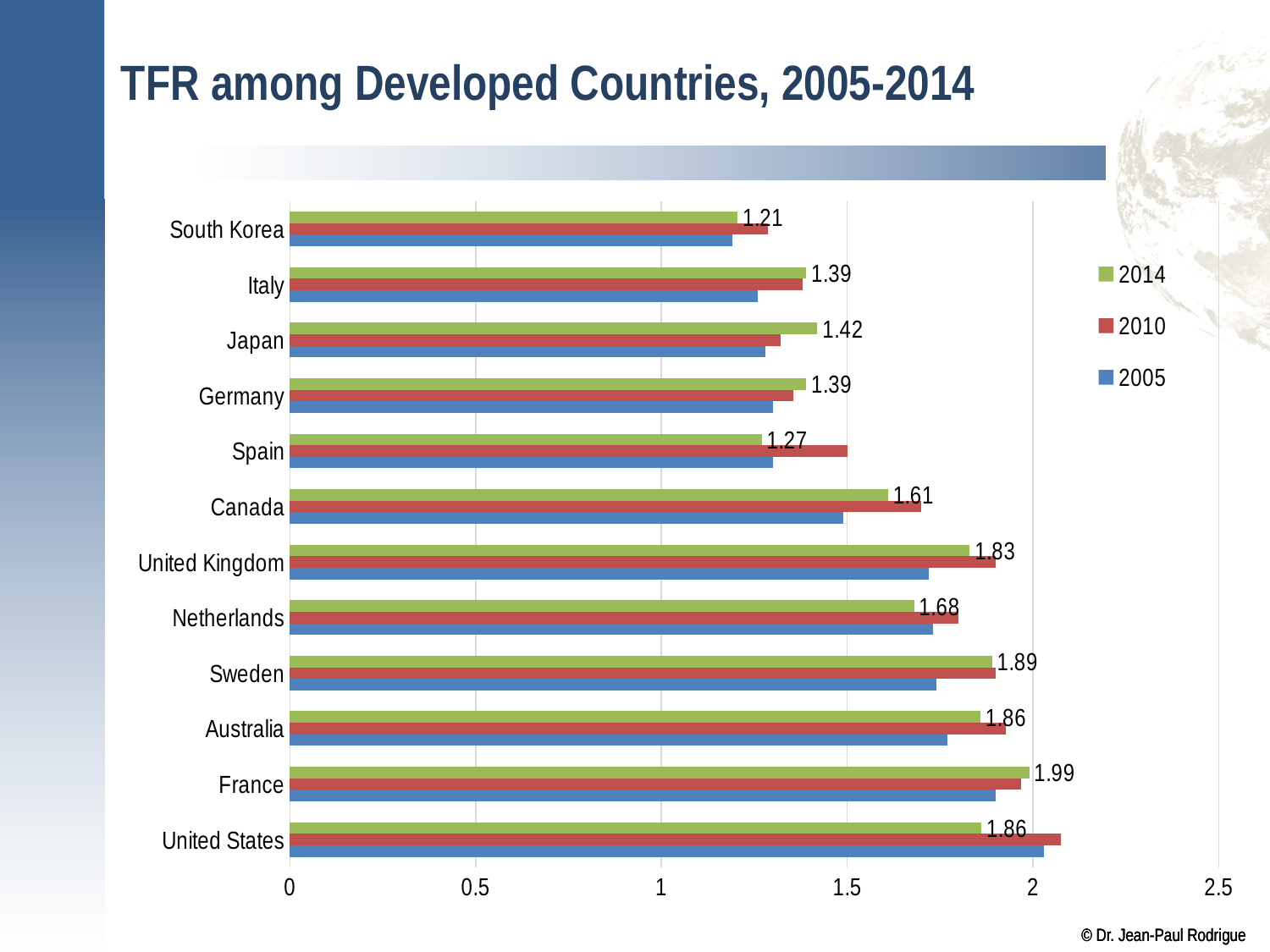
What is the difference between the 2014 TFR values for France and South Korea? 0.78 Which has the larger 2014 TFR value, Japan or Spain? Japan Which country has the highest 2014 TFR value? France What kind of chart is shown on the slide? Bar chart Is the 2005 TFR value for South Korea greater or less than 1.5? less What is the 2014 TFR value for South Korea? 1.21 How many countries are shown in the chart? 12 Which country has the lowest 2014 TFR value? South Korea How many series does the legend list? 3 Is the 2010 TFR value for the United States greater or less than 2? greater What is the 2014 TFR value for the Netherlands? 1.68 What is the 2014 TFR value for France? 1.99